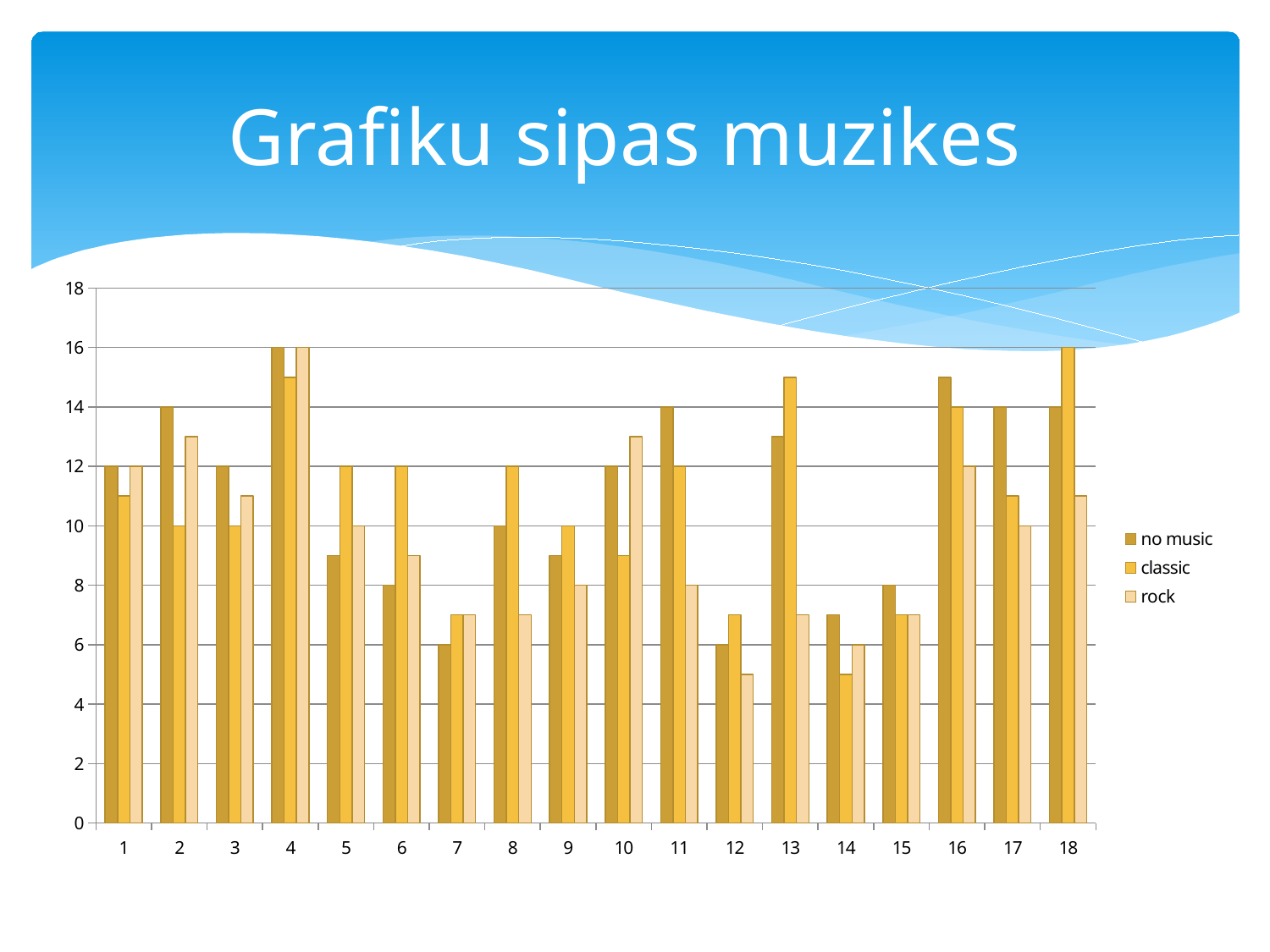
Which category has the lowest 'rock' value? 12 Is the 'classic' value for category 13 greater or less than 14? greater What is the 'classic' value for category 6? 12 How many series does the legend list? 3 How many categories are shown along the x axis? 18 What type of chart is shown on the slide? bar chart For category 13, which is larger: 'no music' or 'classic'? classic What is the 'no music' value for category 4? 16 What is the 'rock' value for category 11? 8 Which category has the highest 'no music' value? 4 What is the title of the chart slide? Grafiku sipas muzikes What is the difference between the 'no music' values for category 4 and category 7? 10